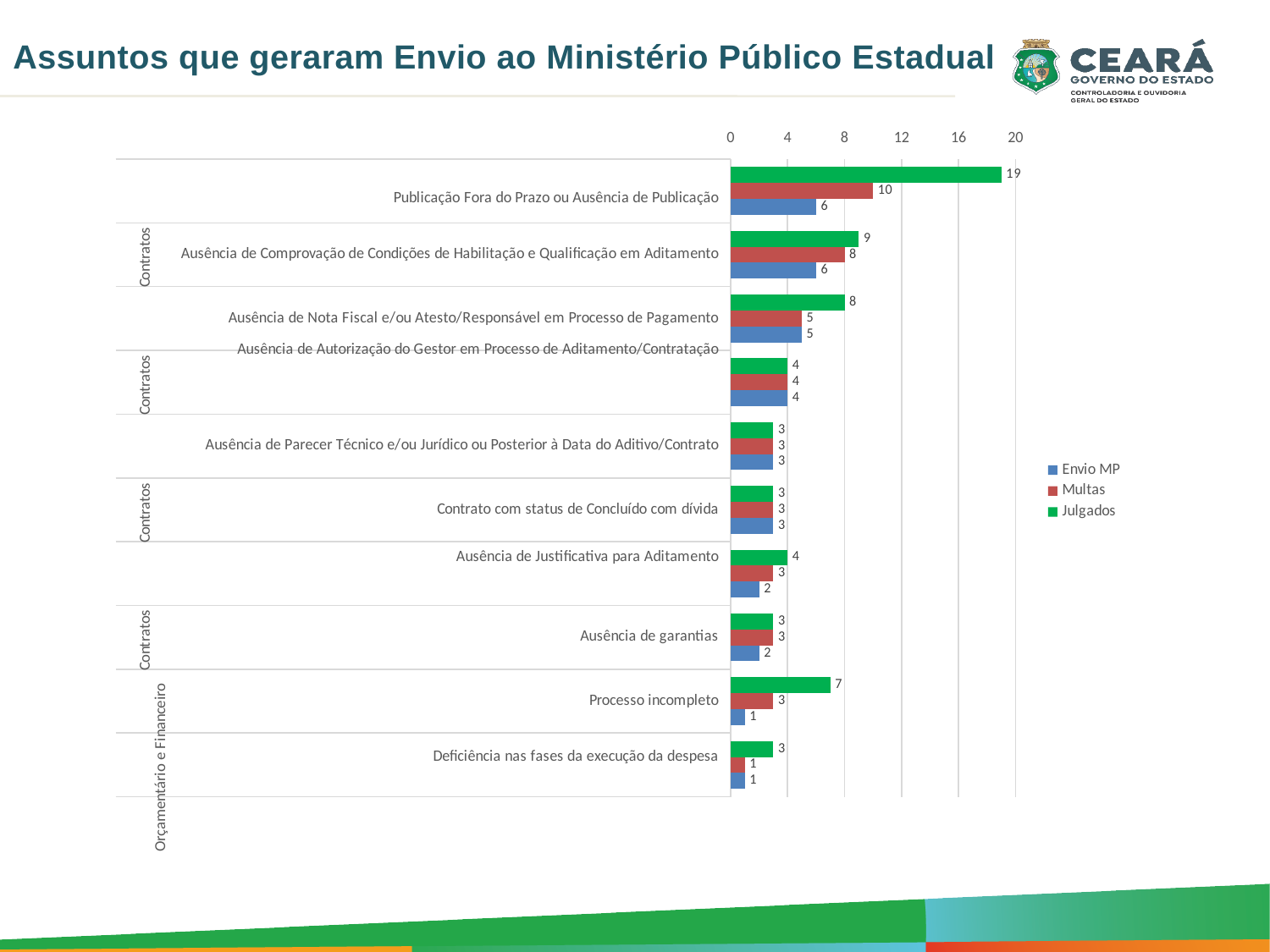
Which category has the highest Julgados value? Publicação Fora do Prazo ou Ausência de Publicação Is the Julgados value for 'Publicação Fora do Prazo ou Ausência de Publicação' greater or less than 16? greater What kind of chart is shown on the slide? Bar chart What is the Envio MP value for 'Processo incompleto'? 1 What is the Julgados value for 'Publicação Fora do Prazo ou Ausência de Publicação'? 19 For 'Processo incompleto', which is larger: the Julgados value or the Multas value? Julgados What is the difference between the Julgados and Envio MP values for 'Publicação Fora do Prazo ou Ausência de Publicação'? 13 What is the Julgados value for 'Ausência de Nota Fiscal e/ou Atesto/Responsável em Processo de Pagamento'? 8 What is the Multas value for 'Publicação Fora do Prazo ou Ausência de Publicação'? 10 How many categories are plotted on the chart? 10 Which colour represents the Multas series in the legend? Red How many series does the legend list? 3